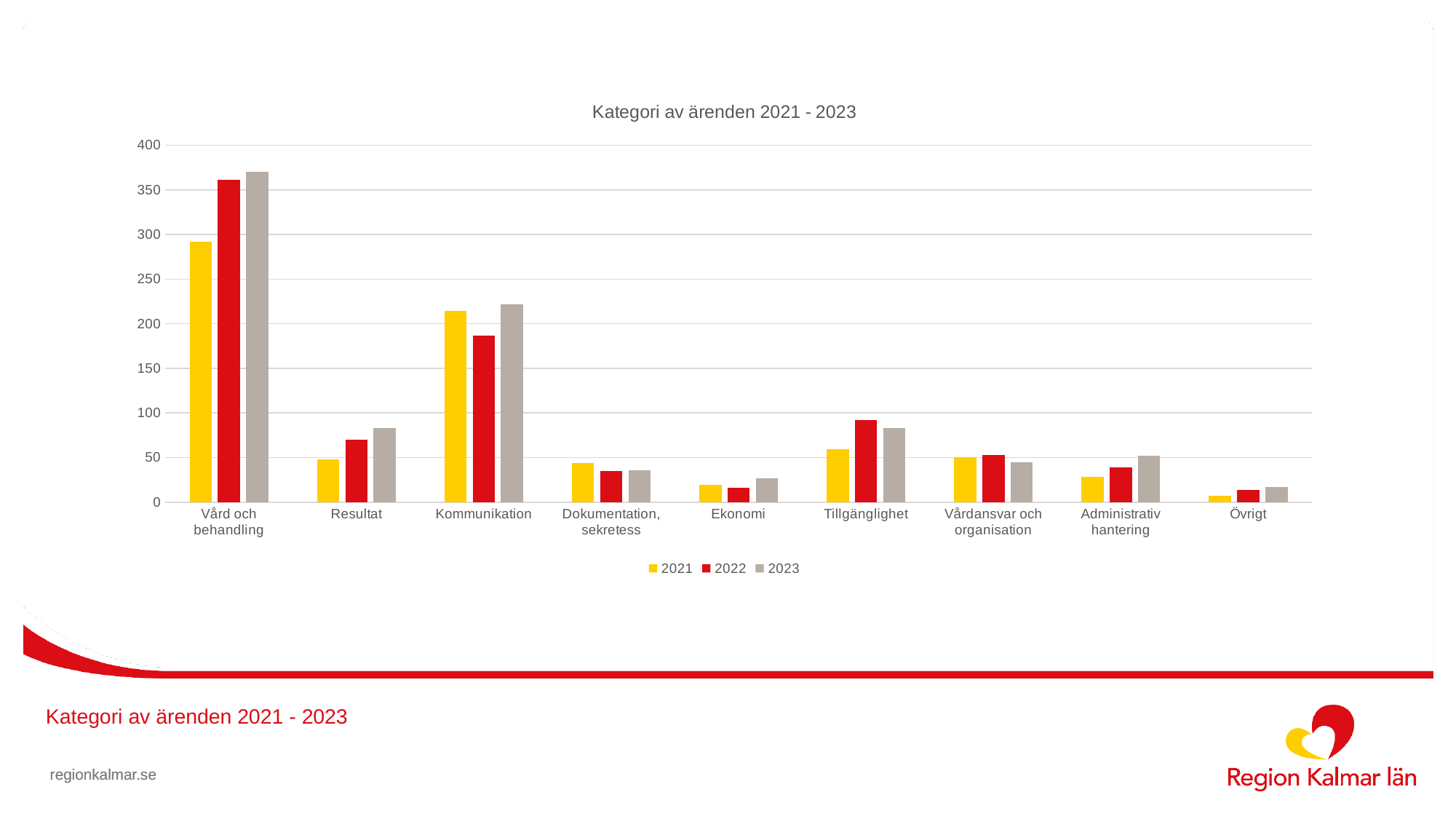
How many series does the legend list? 3 Is the value for Kommunikation in 2022 greater or less than 200? less For Kommunikation, which year has the larger value, 2021 or 2022? 2021 What kind of chart is shown on the slide? bar chart What is the title of the chart? Kategori av ärenden 2021 - 2023 Is the value for Resultat in 2023 greater or less than 100? less How many categories are shown on the x axis of the chart? 9 Is the value for Vård och behandling in 2021 greater or less than 250? greater Which category has the lowest value for 2021? Övrigt Which category has the highest value for 2023? Vård och behandling For Tillgänglighet, which year has the larger value, 2021 or 2022? 2022 Do the values for Administrativ hantering rise or fall from 2021 to 2023? rise